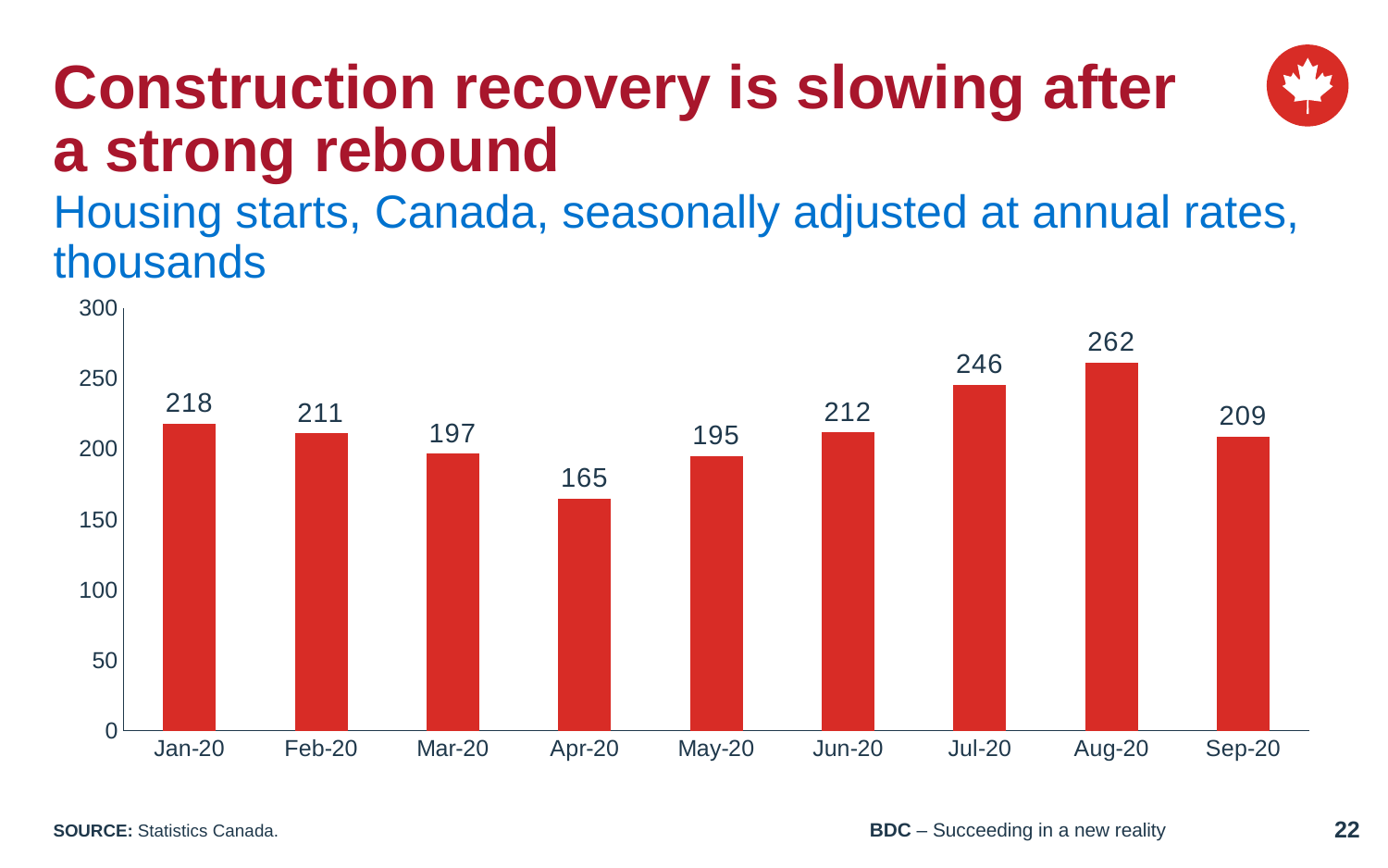
Is the value for Mar-20 greater or less than 200? less What is the value for Aug-20? 262 How many months are shown on the x axis? 9 What is the value for Apr-20? 165 Which month has the lowest value? Apr-20 What kind of chart is shown on the slide? bar chart What is the value for Sep-20? 209 Which is larger, the value for Jul-20 or the value for Jun-20? Jul-20 What is the difference between the values for Jan-20 and Apr-20? 53 Do the values rise or fall from Apr-20 to Aug-20? rise What is the difference between the values for Aug-20 and Sep-20? 53 Which month has the highest value? Aug-20